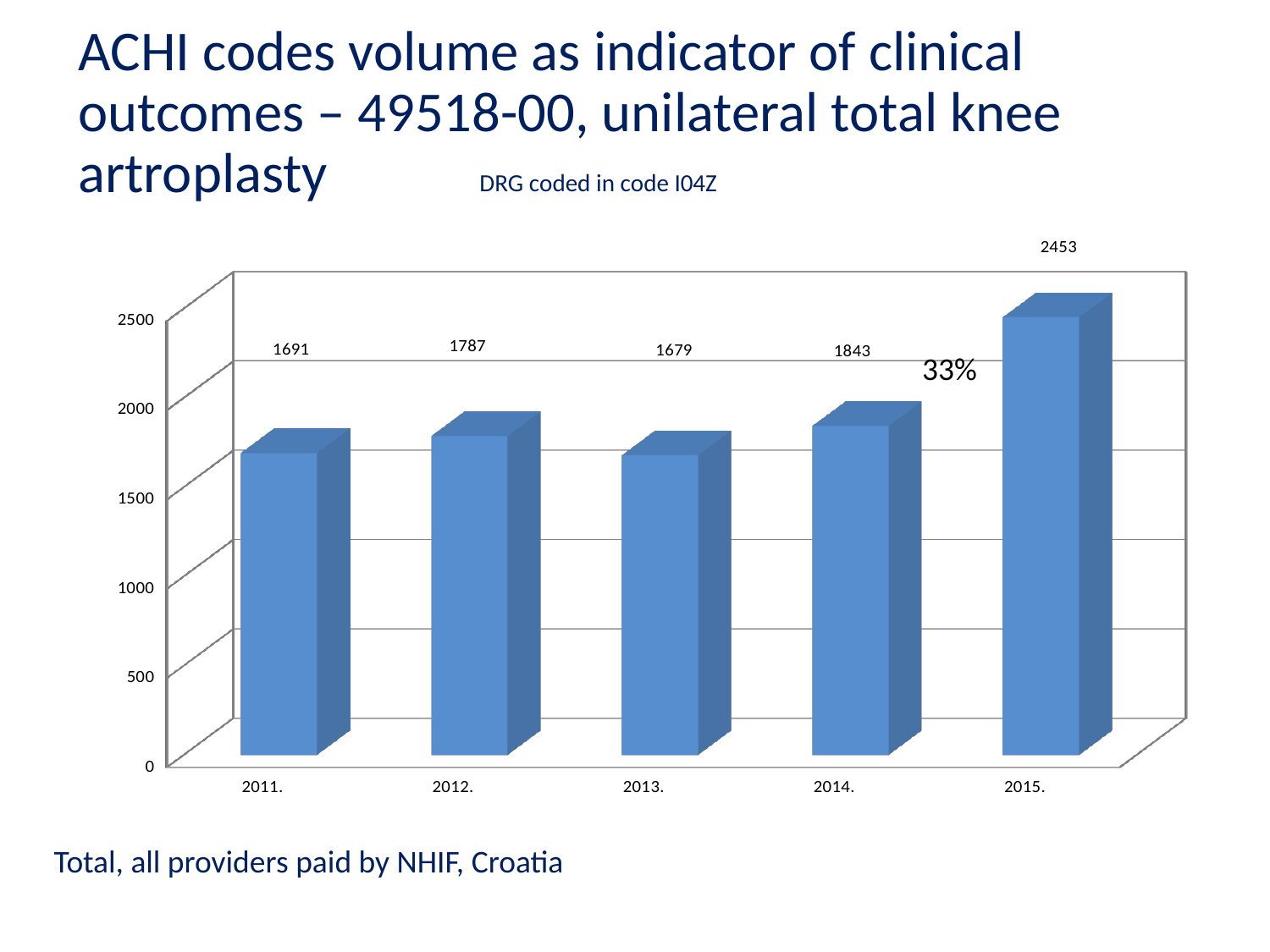
Which year has the highest value? 2015. Which year has the lowest value? 2013. What is the value for 2015.? 2453 What kind of chart is shown on the slide? bar chart What is the difference between the values for 2015. and 2014.? 610 How many years are shown on the x axis? 5 What percentage annotation is printed near the 2014. and 2015. bars? 33% Is the value for 2015. greater or less than 2000? greater What is the value for 2014.? 1843 What is the value for 2011.? 1691 What is the difference between the values for 2012. and 2011.? 96 Which is larger, the value for 2012. or the value for 2013.? 2012.